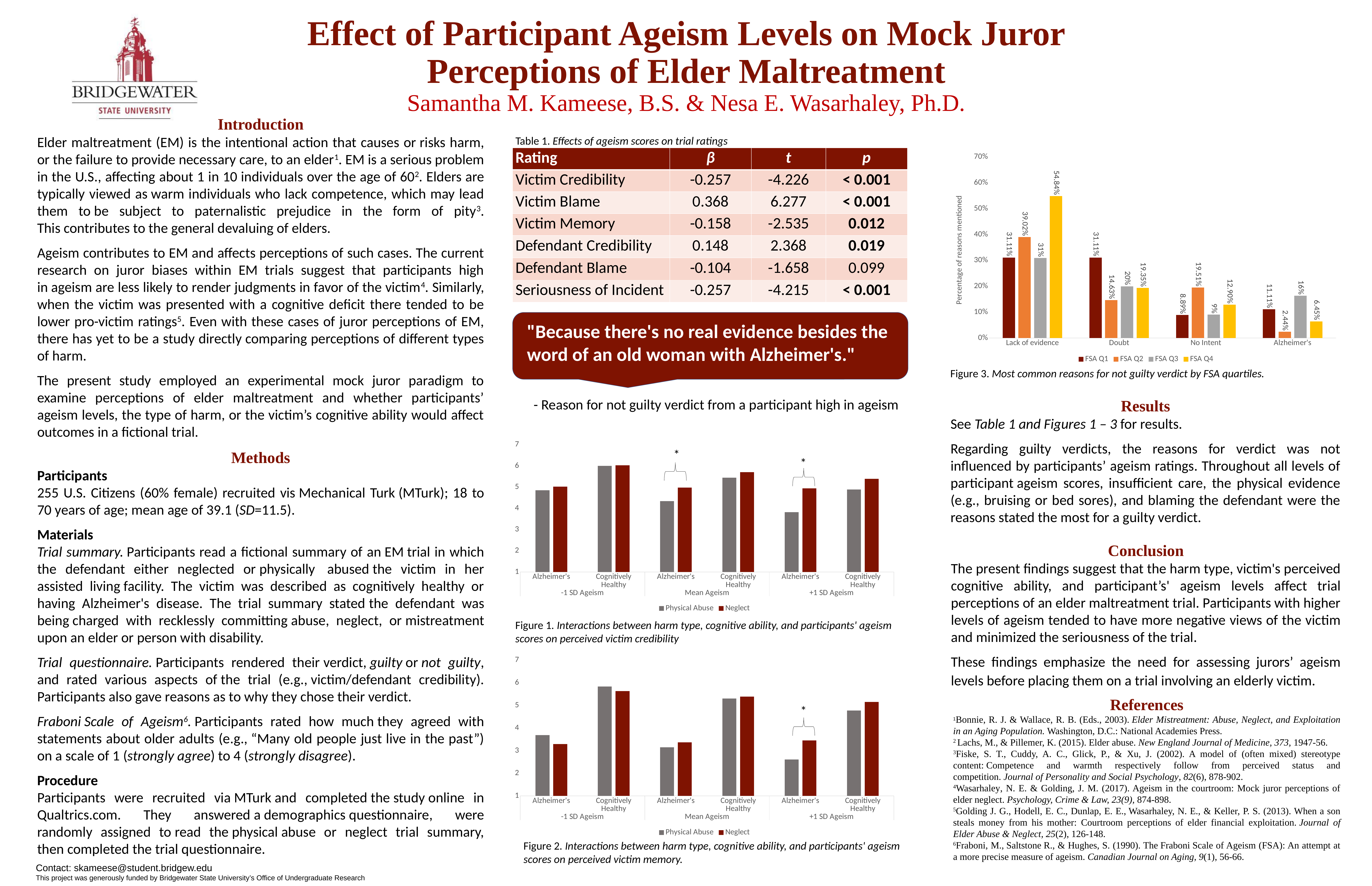
In Figure 3, which FSA quartile has the lowest value under 'Alzheimer's'? FSA Q2 In Figure 3, what is the value for FSA Q2 under 'No Intent'? 19.51% In Figure 3, how many reason categories are shown on the x axis? 4 In Figure 3, how many series does the legend list? 4 What kind of chart is Figure 1? bar chart In Figure 2, is the Physical Abuse value for Cognitively Healthy at -1 SD Ageism greater or less than 5? greater In Figure 1, is the Physical Abuse value for Alzheimer's at +1 SD Ageism greater or less than 4? less In Figure 3, what is the difference between the FSA Q1 and FSA Q2 values under 'Doubt'? 16.48% In Figure 3, what percentage of reasons mentioned is shown for FSA Q4 under 'Lack of evidence'? 54.84% In Figure 3, is the FSA Q3 value under 'Alzheimer's' larger or smaller than the FSA Q4 value under 'Alzheimer's'? larger In Figure 3, which FSA quartile has the highest value under 'Lack of evidence'? FSA Q4 In Figure 2, which series has the larger value for Alzheimer's at +1 SD Ageism, Physical Abuse or Neglect? Neglect